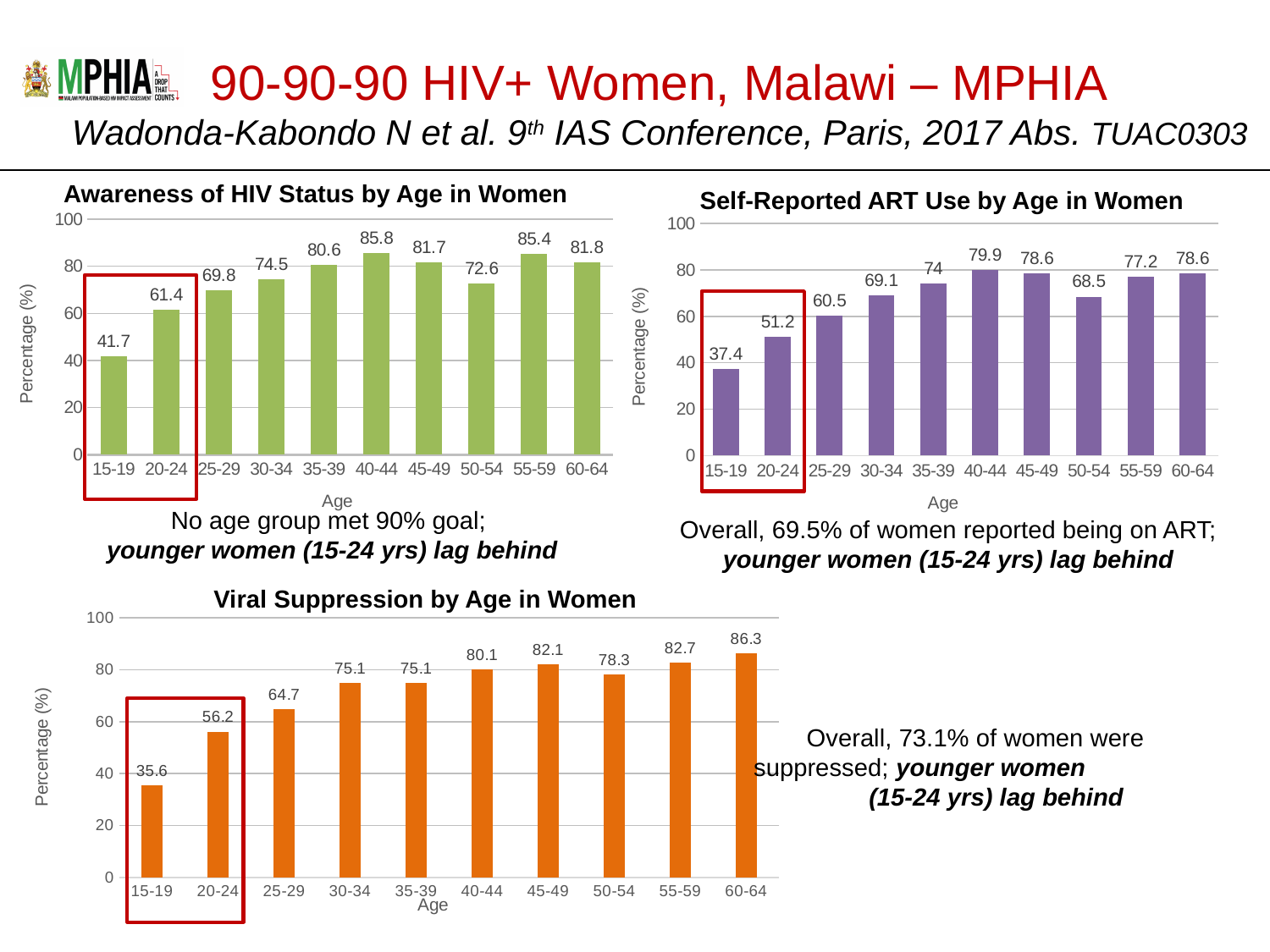
In the 'Self-Reported ART Use by Age in Women' chart, which is larger, the value for 50-54 or the value for 55-59? 55-59 How many age groups are shown in the 'Viral Suppression by Age in Women' chart? 10 In the 'Self-Reported ART Use by Age in Women' chart, which age group has the lowest value? 15-19 In the 'Viral Suppression by Age in Women' chart, is the value for 25-29 greater or less than 60? greater In the 'Awareness of HIV Status by Age in Women' chart, what is the value for the 15-19 age group? 41.7 What type of chart is the 'Self-Reported ART Use by Age in Women' chart? Bar chart In the 'Viral Suppression by Age in Women' chart, what is the difference between the 60-64 and 15-19 values? 50.7 In the 'Self-Reported ART Use by Age in Women' chart, what is the value for the 40-44 age group? 79.9 In the 'Awareness of HIV Status by Age in Women' chart, which age group has the highest value? 40-44 In the 'Awareness of HIV Status by Age in Women' chart, what is the difference between the 20-24 and 15-19 values? 19.7 What colour are the bars in the 'Awareness of HIV Status by Age in Women' chart? Green In the 'Viral Suppression by Age in Women' chart, what is the value for the 60-64 age group? 86.3